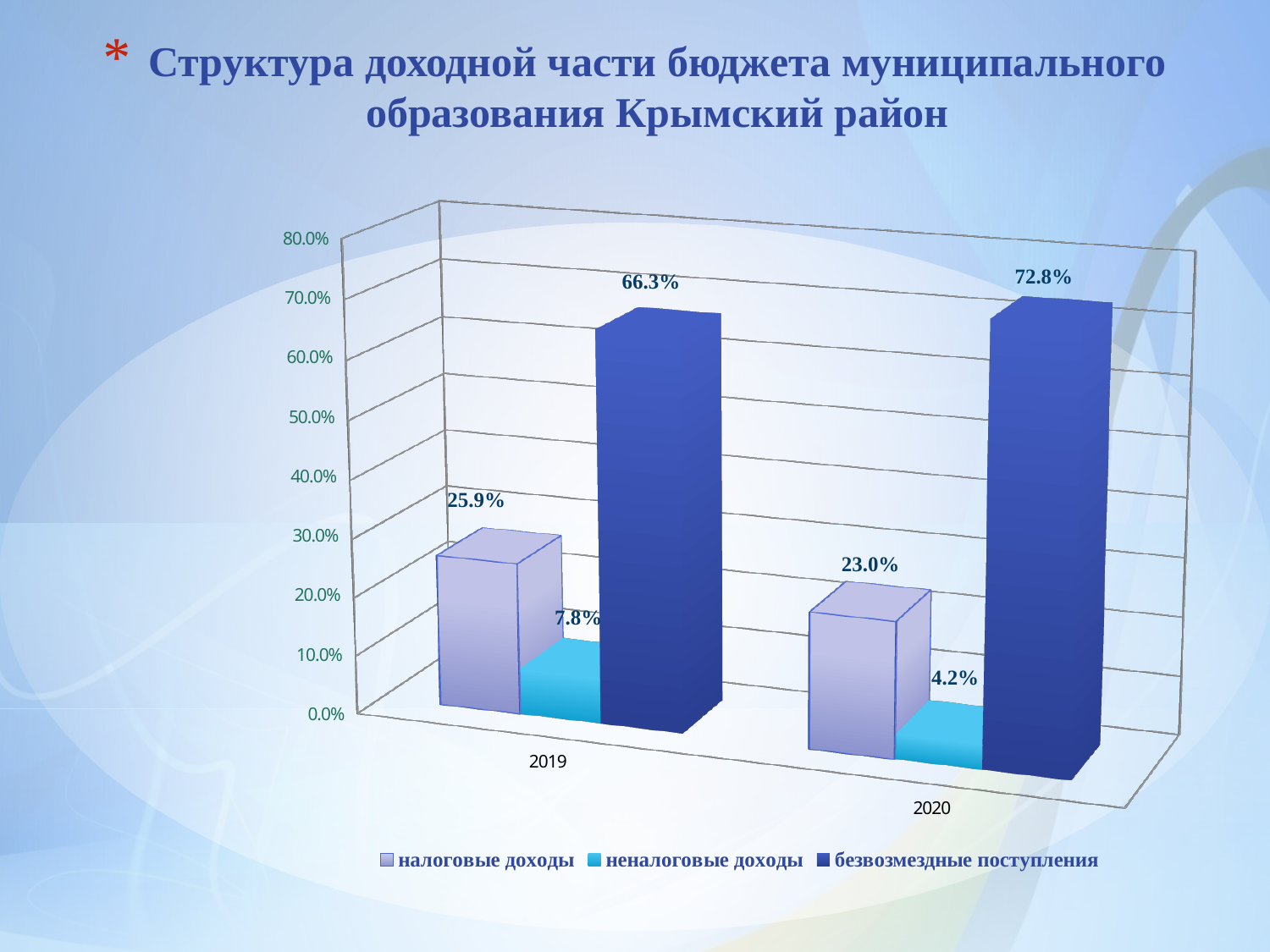
How many years are shown on the x axis? 2 What is the difference between безвозмездные поступления in 2020 and in 2019? 6.5% What is the value for безвозмездные поступления in 2020? 72.8% What is the value for неналоговые доходы in 2020? 4.2% What is the value for безвозмездные поступления in 2019? 66.3% What kind of chart is shown on the slide? bar chart Which series has the highest value in 2020? безвозмездные поступления Does the value for неналоговые доходы rise or fall from 2019 to 2020? fall Which is larger: налоговые доходы in 2019 or налоговые доходы in 2020? налоговые доходы in 2019 Which series has the lowest value in 2019? неналоговые доходы What is the value for налоговые доходы in 2019? 25.9% How many series does the legend list? 3